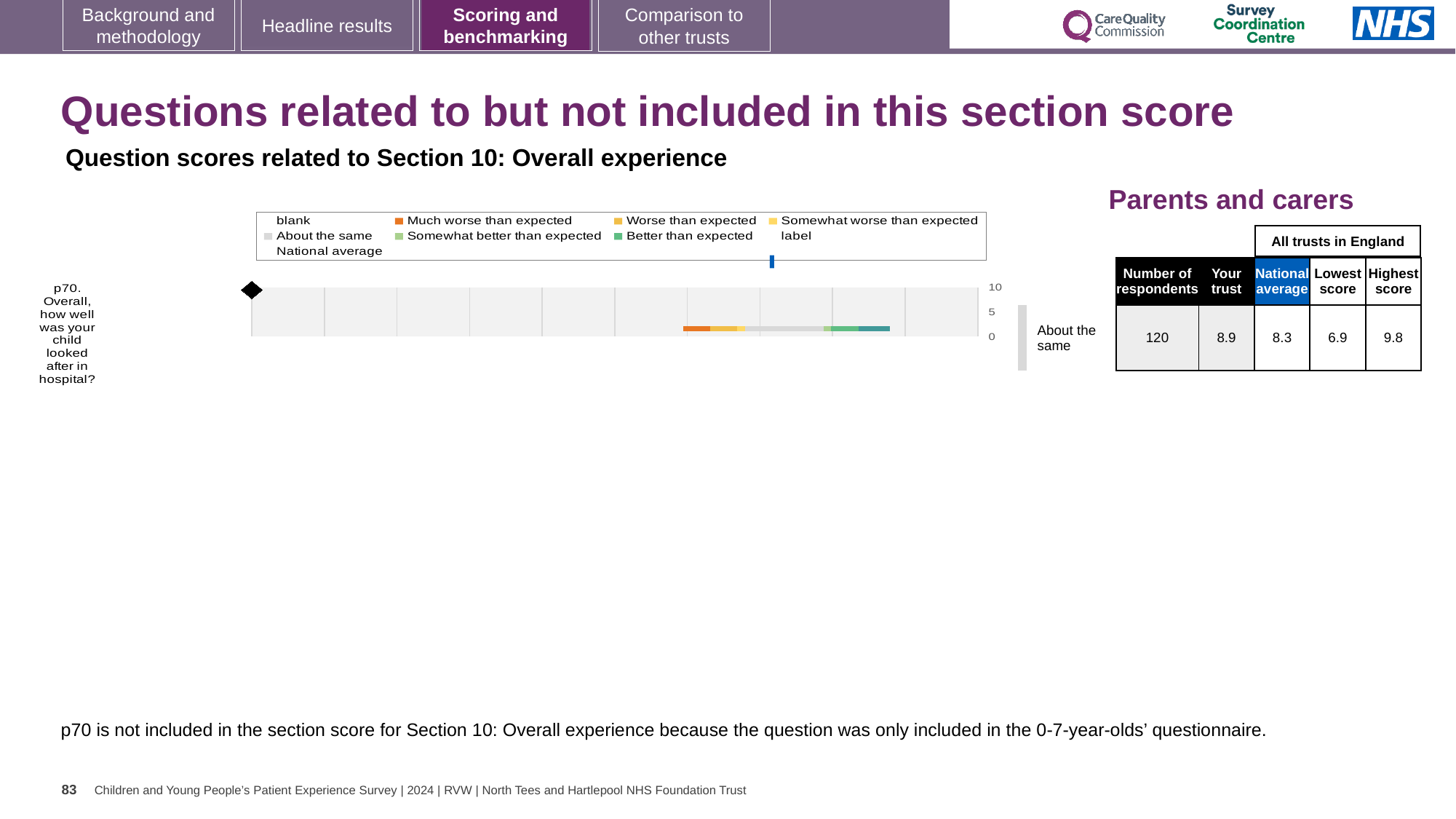
What is the highest value shown on the chart's numeric axis? 10 How many respondents answered p70? 120 What is the lowest score among all trusts in England for p70? 6.9 What is the highest score among all trusts in England for p70? 9.8 What is the national average score for p70? 8.3 What kind of chart is used to show the p70 question score? bar chart What benchmark category is shown next to the bar for p70? About the same How many survey questions are plotted in the chart? 1 What is the 'Your trust' score for p70 in the Parents and carers table? 8.9 What is the difference between the highest and lowest trust scores for p70? 2.9 Which is higher for p70, the 'Your trust' score or the national average? Your trust What is the difference between the 'Your trust' score and the national average for p70? 0.6